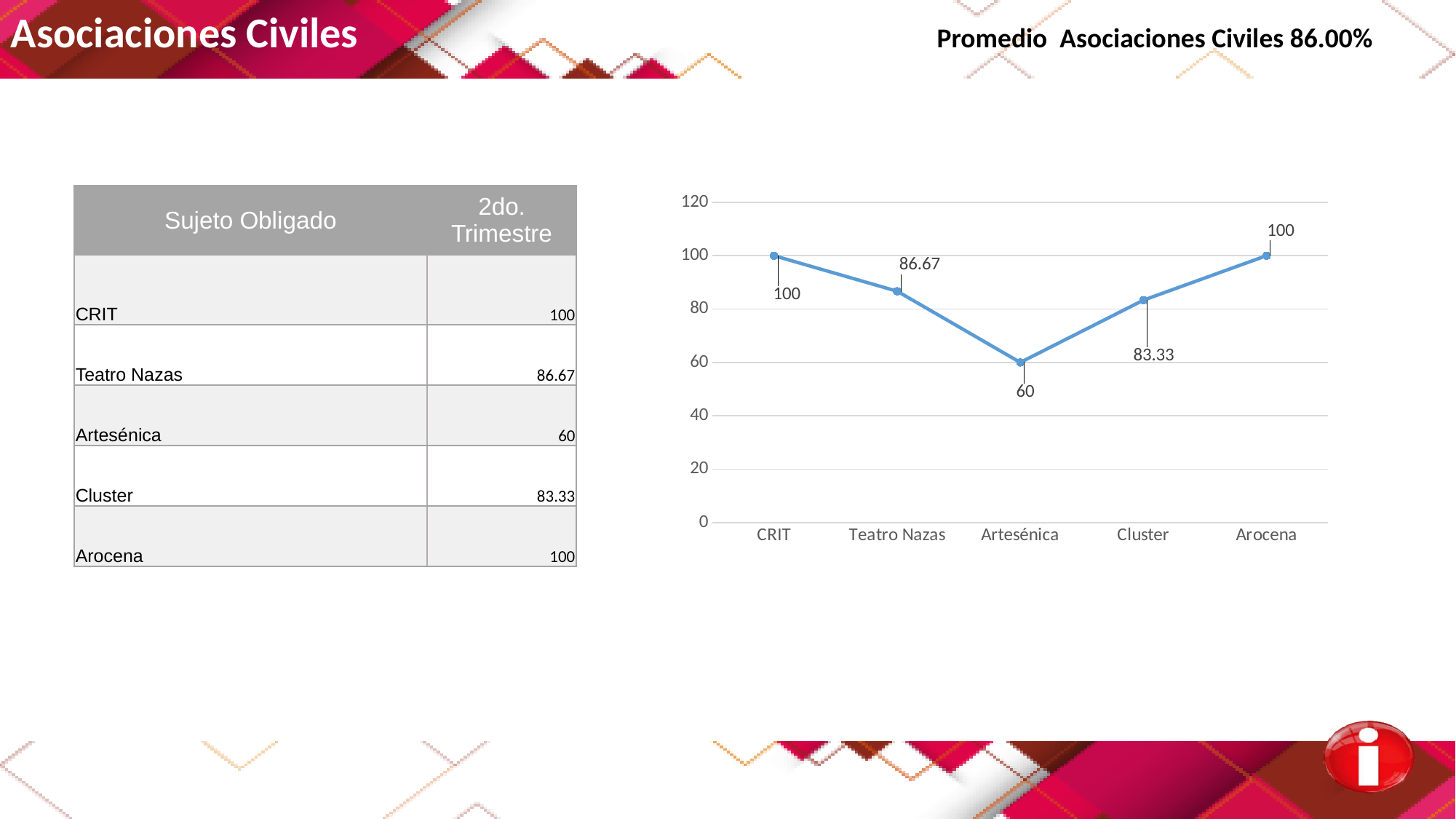
What is the value for Cluster in the chart? 83.33 What kind of chart is shown on the slide? line chart Is the value for Cluster greater or less than 80? greater What is the value for Artesénica in the chart? 60 What is the difference between the values for Teatro Nazas and Artesénica? 26.67 What is the difference between the values for Arocena and Cluster? 16.67 Do the values rise or fall from Artesénica to Arocena along the x axis? rise How many categories are plotted on the x axis of the chart? 5 Which category has the lowest value in the chart? Artesénica What is the value for CRIT in the chart? 100 What is the value for Teatro Nazas in the chart? 86.67 Which is larger, the value for Teatro Nazas or the value for Cluster? Teatro Nazas